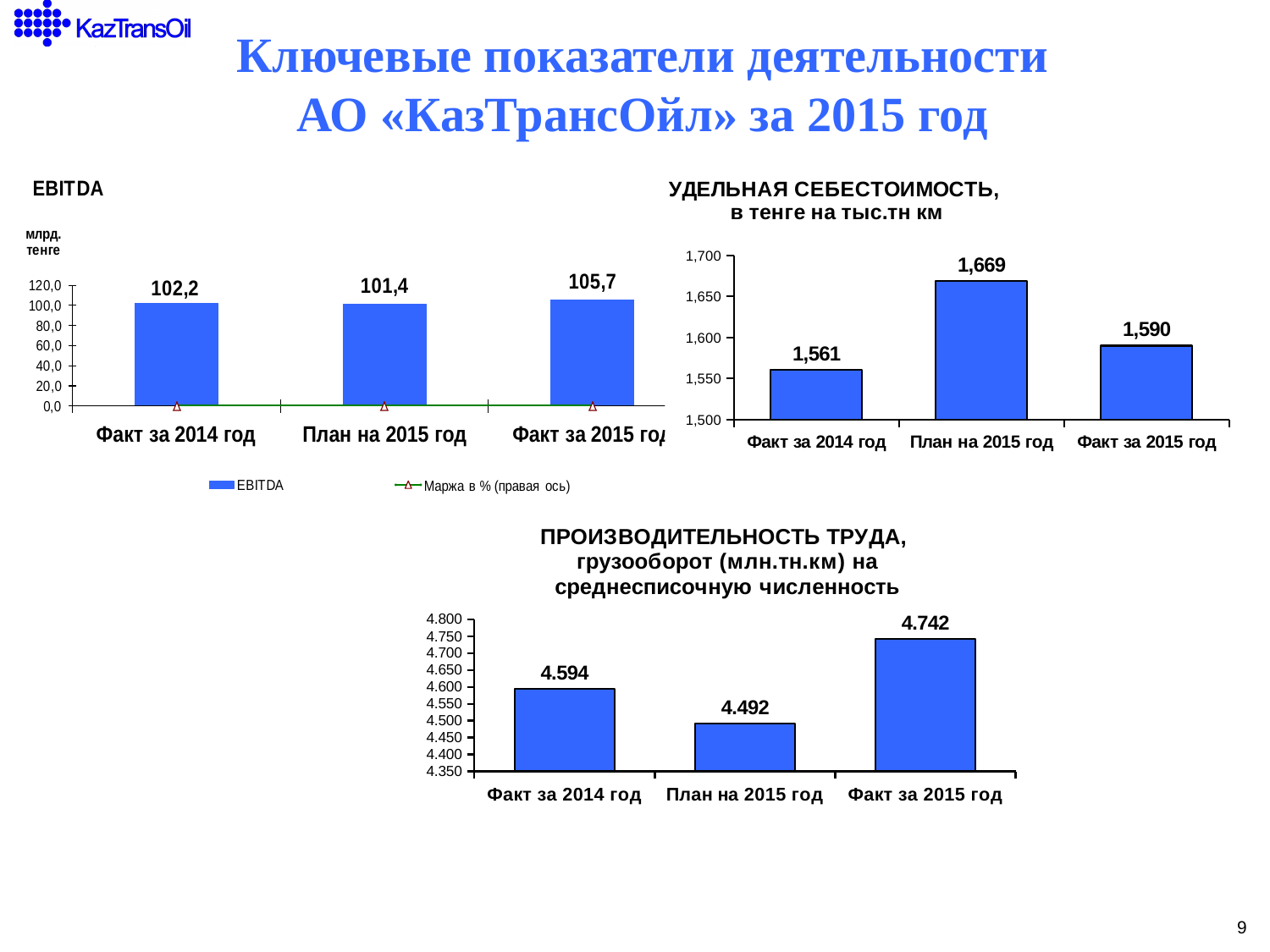
In the EBITDA chart, what is the difference between Факт за 2015 год and Факт за 2014 год? 3,5 How many categories are shown in the ПРОИЗВОДИТЕЛЬНОСТЬ ТРУДА chart? 3 In the ПРОИЗВОДИТЕЛЬНОСТЬ ТРУДА chart, what is the value for Факт за 2014 год? 4.594 What kind of chart is the УДЕЛЬНАЯ СЕБЕСТОИМОСТЬ chart? bar chart In the УДЕЛЬНАЯ СЕБЕСТОИМОСТЬ chart, which category has the highest value? План на 2015 год In the УДЕЛЬНАЯ СЕБЕСТОИМОСТЬ chart, what is the difference between План на 2015 год and Факт за 2014 год? 108 In the ПРОИЗВОДИТЕЛЬНОСТЬ ТРУДА chart, which is larger, Факт за 2015 год or План на 2015 год? Факт за 2015 год In the EBITDA chart, what is the value for Факт за 2015 год? 105,7 How many series does the legend of the EBITDA chart list? 2 In the УДЕЛЬНАЯ СЕБЕСТОИМОСТЬ chart, is the value for Факт за 2014 год greater or less than 1,600? less In the EBITDA chart, which category has the lowest value? План на 2015 год In the УДЕЛЬНАЯ СЕБЕСТОИМОСТЬ chart, what is the value for План на 2015 год? 1,669